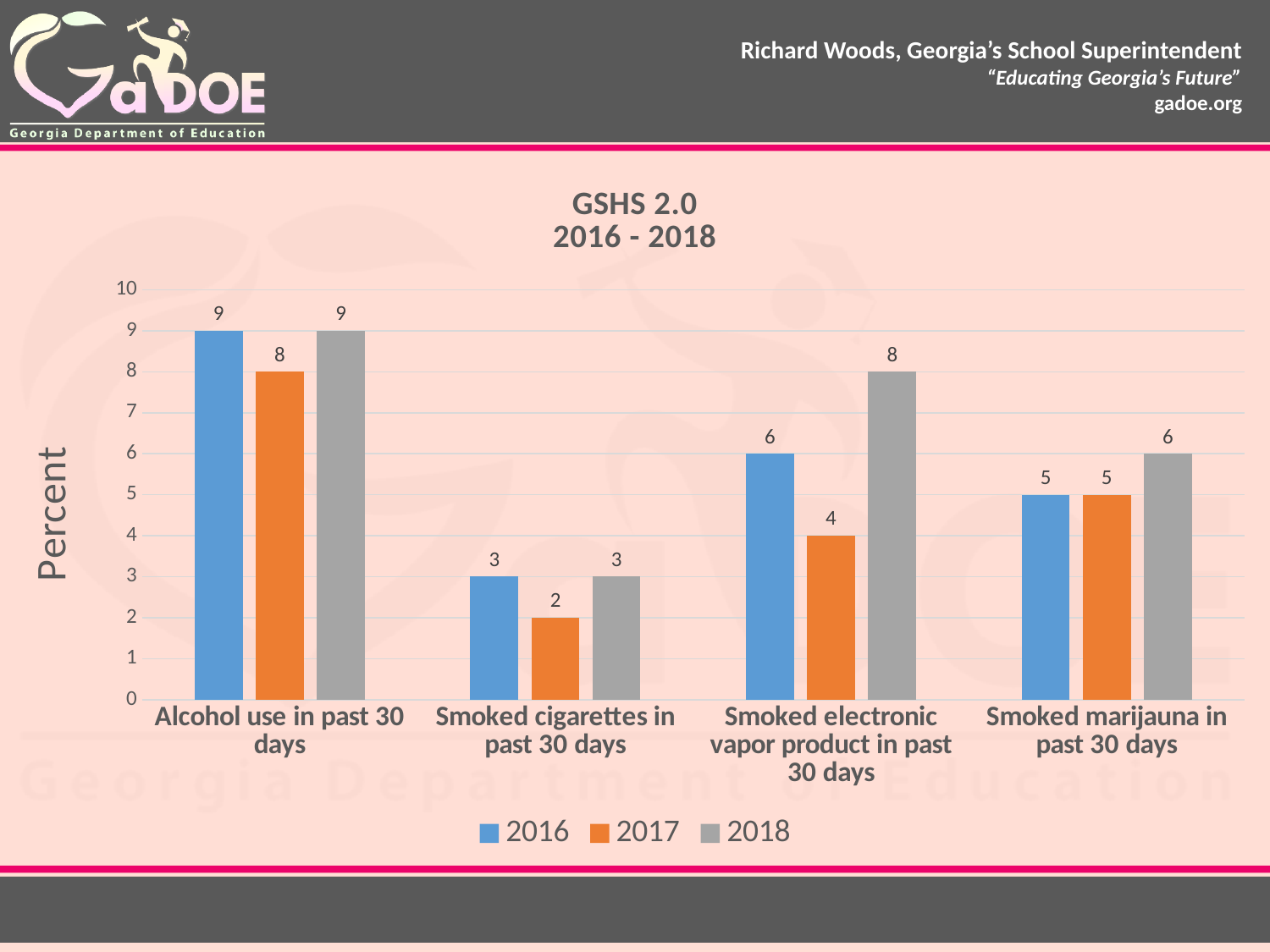
How many series does the legend list? 3 What is the label on the vertical axis? Percent Which category has the highest 2018 value? Alcohol use in past 30 days What kind of chart is shown? Bar chart What is the difference between the 2018 and 2017 values for Smoked electronic vapor product in past 30 days? 4 Which is larger for Smoked electronic vapor product in past 30 days: the 2016 value or the 2017 value? 2016 What is the 2017 value for Smoked marijauna in past 30 days? 5 What is the 2016 value for Alcohol use in past 30 days? 9 What is the 2017 value for Smoked cigarettes in past 30 days? 2 What is the 2018 value for Smoked electronic vapor product in past 30 days? 8 How many categories are shown on the x axis? 4 Which category has the lowest 2017 value? Smoked cigarettes in past 30 days